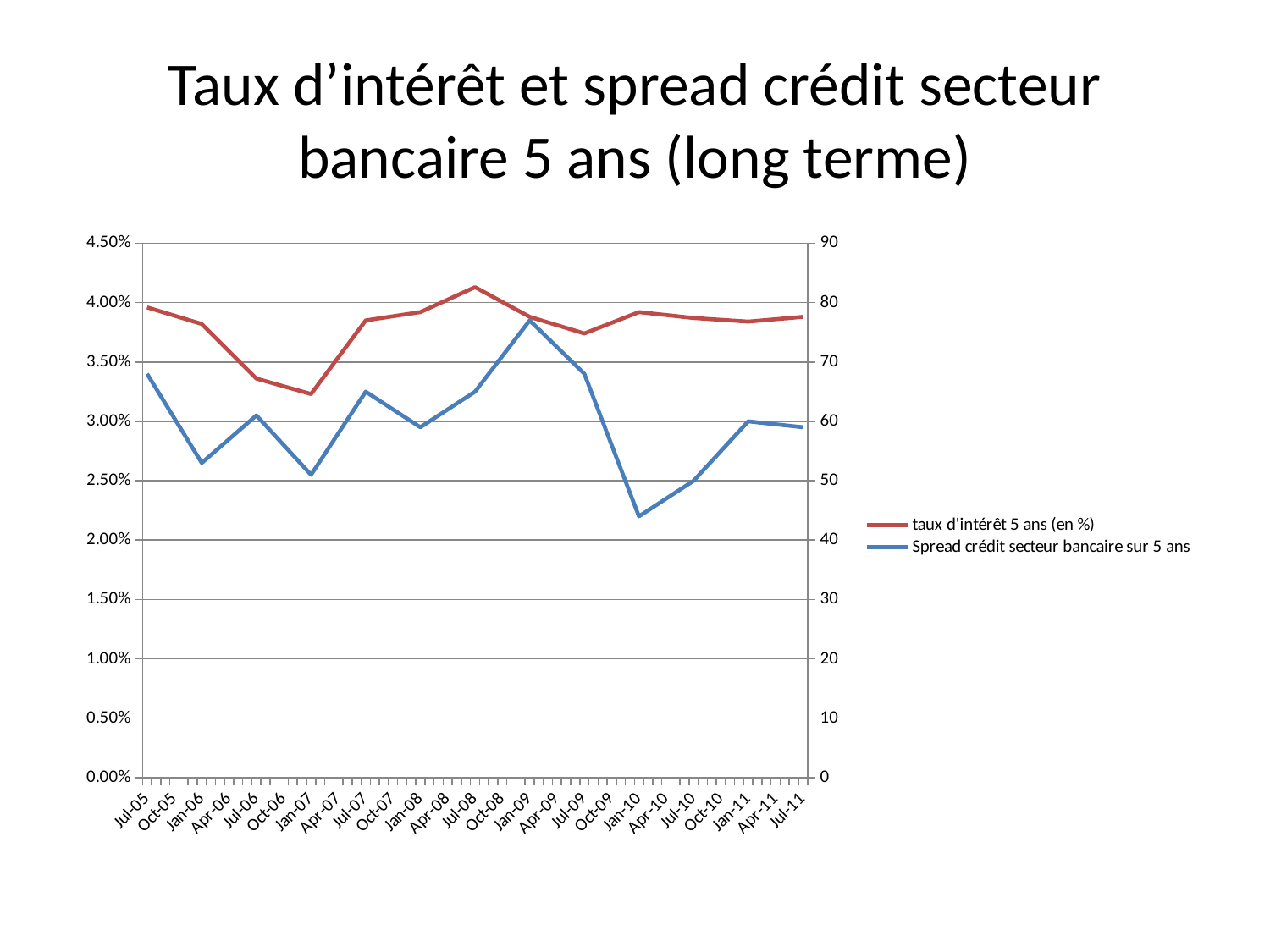
At which date does the 'Spread crédit secteur bancaire sur 5 ans' line reach its lowest value? Jan-10 Is the value of 'Spread crédit secteur bancaire sur 5 ans' at Jan-09 greater or less than 70? greater Does the 'Spread crédit secteur bancaire sur 5 ans' line rise or fall between Jan-09 and Jan-10? fall Is the value of 'taux d'intérêt 5 ans (en %)' at Jan-07 greater or less than 3.50%? less At which date does the 'Spread crédit secteur bancaire sur 5 ans' line reach its highest value? Jan-09 How many series does the legend list? 2 What colour is the 'Spread crédit secteur bancaire sur 5 ans' line? blue How many date labels are shown along the x axis? 25 What kind of chart is shown on the slide? line chart Which is larger for 'taux d'intérêt 5 ans (en %)': the value at Jul-05 or the value at Jan-07? Jul-05 Is the value of 'taux d'intérêt 5 ans (en %)' at Jul-08 greater or less than 4.00%? greater At which date does the 'taux d'intérêt 5 ans (en %)' line reach its highest value? Jul-08